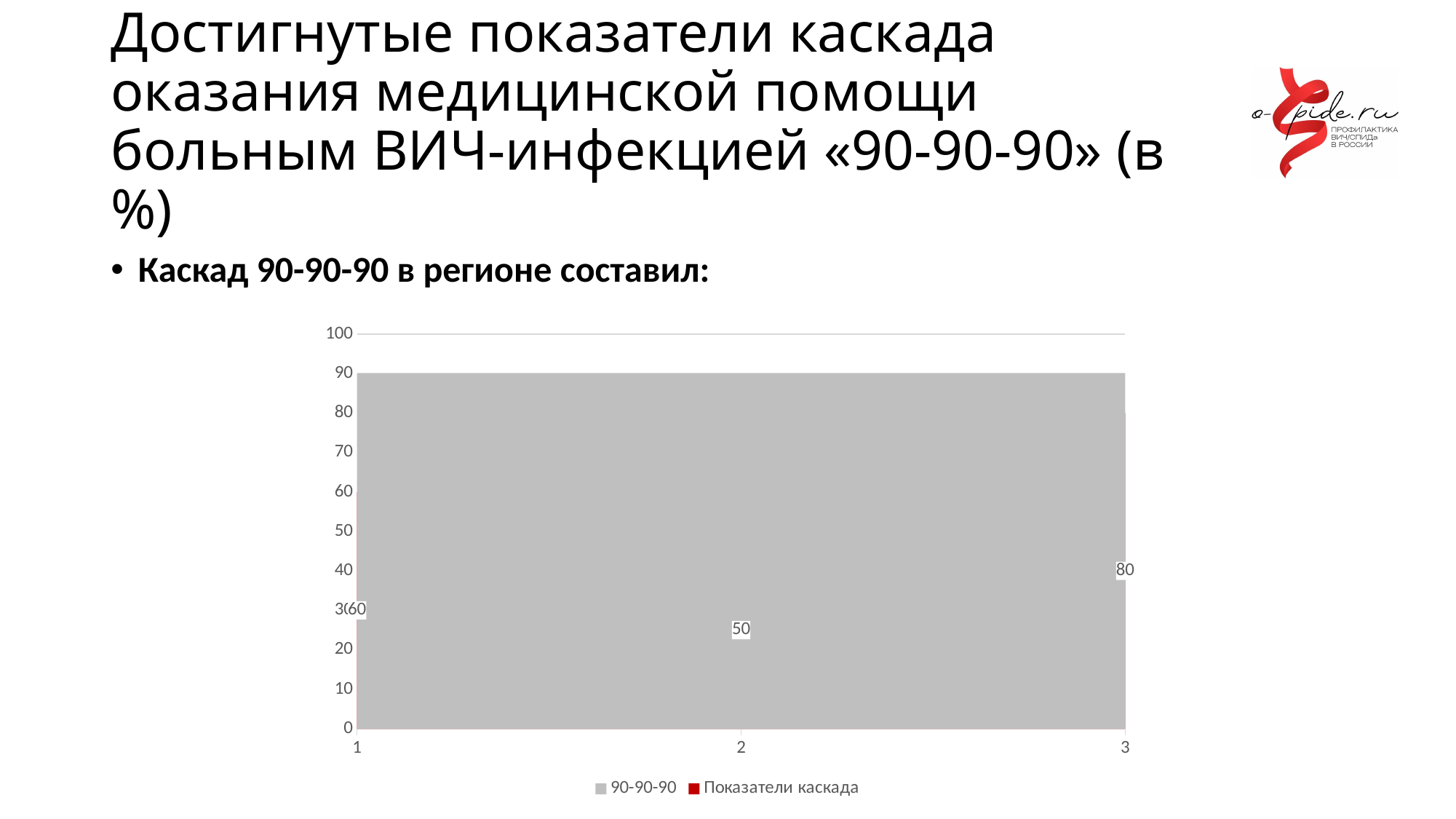
Is the level of the 90-90-90 series greater or less than 80? greater What is the difference between the Показатели каскада values at point 3 and point 2? 30 What is the value of the Показатели каскада series at point 2? 50 What are the two series named in the chart legend? 90-90-90 and Показатели каскада What is the value of the Показатели каскада series at point 3? 80 Which is larger for the Показатели каскада series: the value at point 1 or at point 2? point 1 At which point does the Показатели каскада series reach its highest value? 3 How many series does the chart legend list? 2 At which point does the Показатели каскада series have its lowest value? 2 What kind of chart is shown on the slide? area chart How many points are plotted along the x axis of the chart? 3 What is the value of the Показатели каскада series at point 1? 60